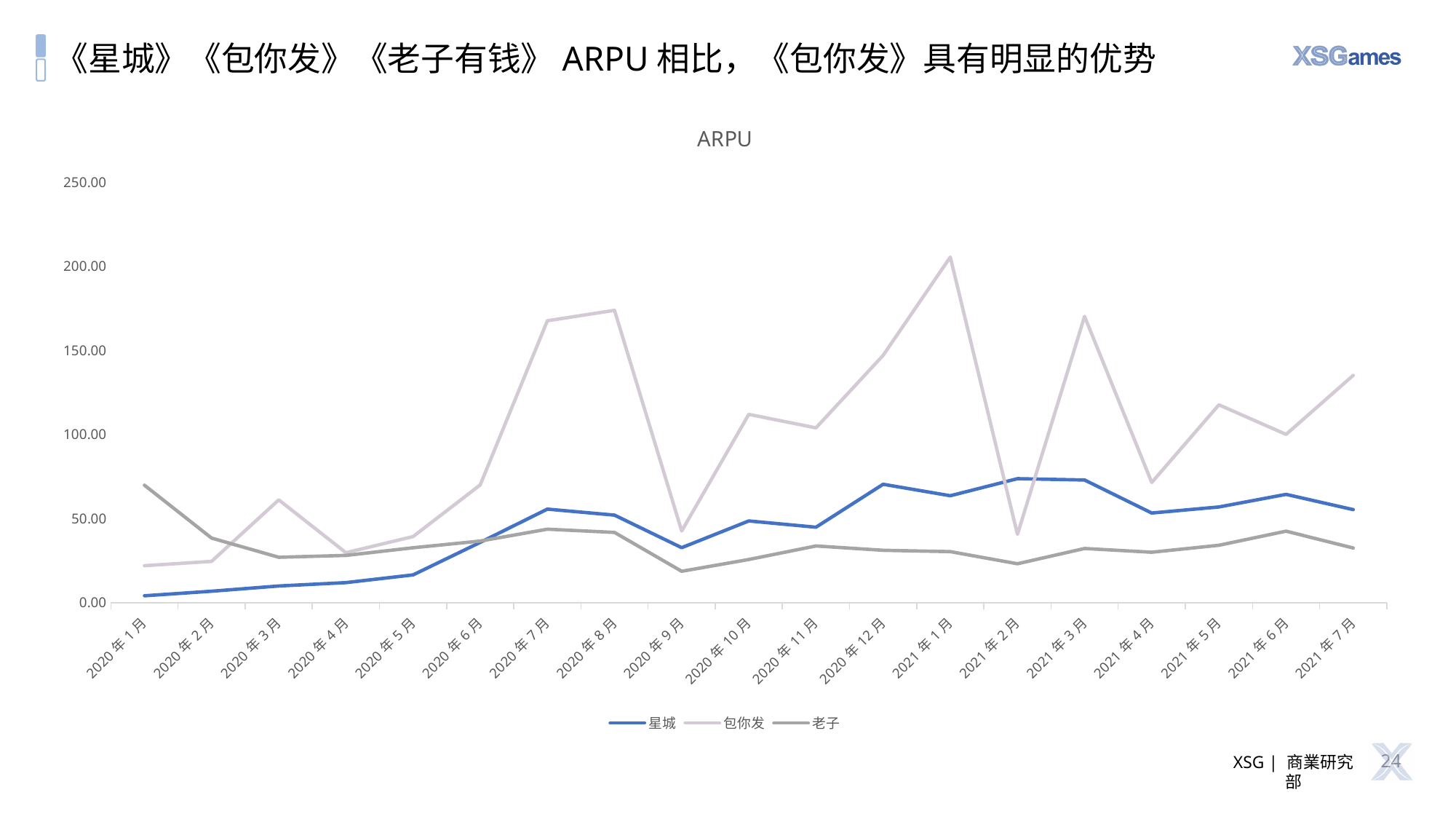
In which month is the value for 星城 lowest? 2020 年 1 月 How many series does the legend list? 3 In which month does 包你发 reach its peak? 2021 年 1 月 In 2020 年 1 月, which is larger: 老子 or 星城? 老子 What is the title of the chart? ARPU Does the value for 星城 rise or fall from 2020 年 1 月 to 2020 年 7 月? rise What kind of chart is shown on the slide? line chart Is the value for 包你发 in 2021 年 1 月 greater or less than 200? greater How many months are plotted along the x axis? 19 Which series reaches the highest value on the chart? 包你发 Is the value for 包你发 in 2021 年 2 月 greater or less than 50? less Is the value for 星城 in 2020 年 1 月 greater or less than 50? less